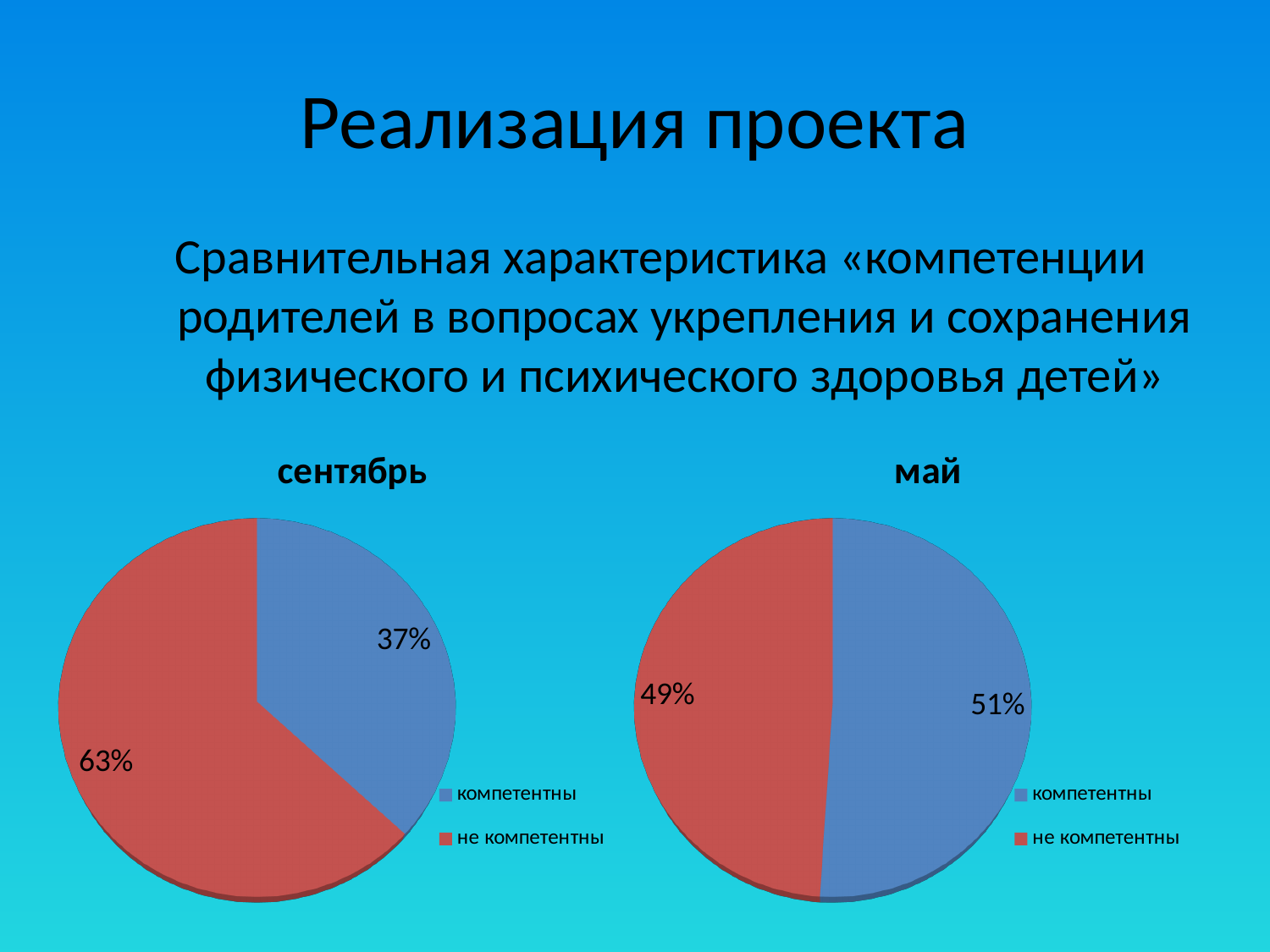
In the "сентябрь" chart, which category has the largest slice? не компетентны In the "сентябрь" chart, which category has the smallest slice? компетентны In the "май" chart, what is the difference between the "компетентны" and "не компетентны" shares? 2% In the "сентябрь" chart, what is the difference between the "не компетентны" and "компетентны" shares? 26% What type of chart is the "май" chart? pie chart In the "май" chart, what share is labelled for "компетентны"? 51% In the "сентябрь" chart, what share is labelled for "не компетентны"? 63% Which chart shows a larger share for "компетентны", "сентябрь" or "май"? май How many categories does the legend of the "сентябрь" chart list? 2 In the "май" chart, what share is labelled for "не компетентны"? 49% In the "сентябрь" chart, what share is labelled for "компетентны"? 37% In the "май" chart, what colour is the "не компетентны" slice? red